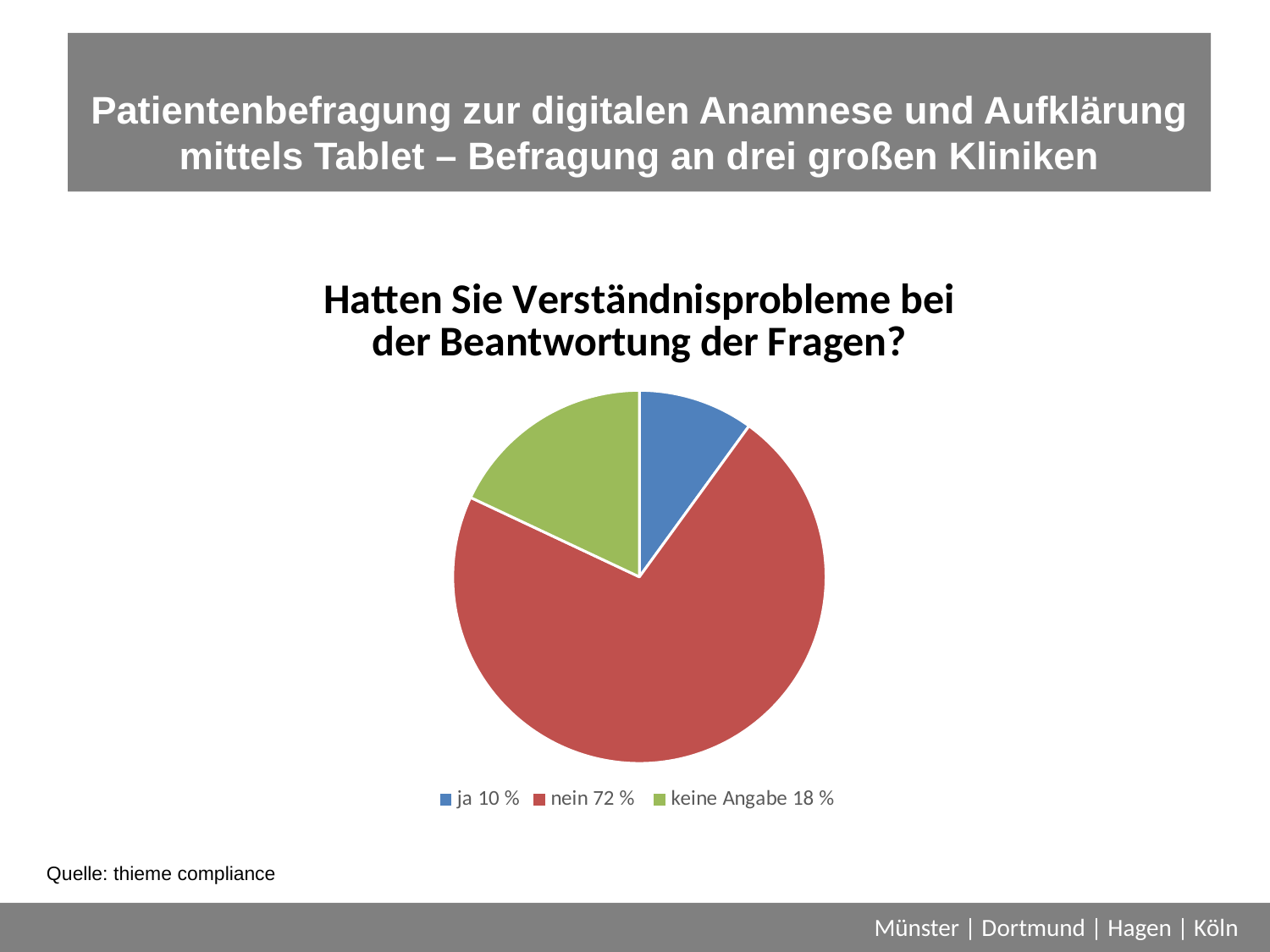
What colour is the slice for "nein"? red What is the chart's title? Hatten Sie Verständnisprobleme bei der Beantwortung der Fragen? What share of respondents gave "keine Angabe"? 18 % What is the difference in percentage points between "nein" and "keine Angabe"? 54 How many entries does the legend list? 3 How many slices does the pie chart have? 3 What share of respondents answered "nein"? 72 % Which is larger, the share for "keine Angabe" or the share for "ja"? keine Angabe What kind of chart is shown on the slide? pie chart Which answer has the smallest slice of the pie? ja What share of respondents answered "ja"? 10 % Which answer has the largest slice of the pie? nein